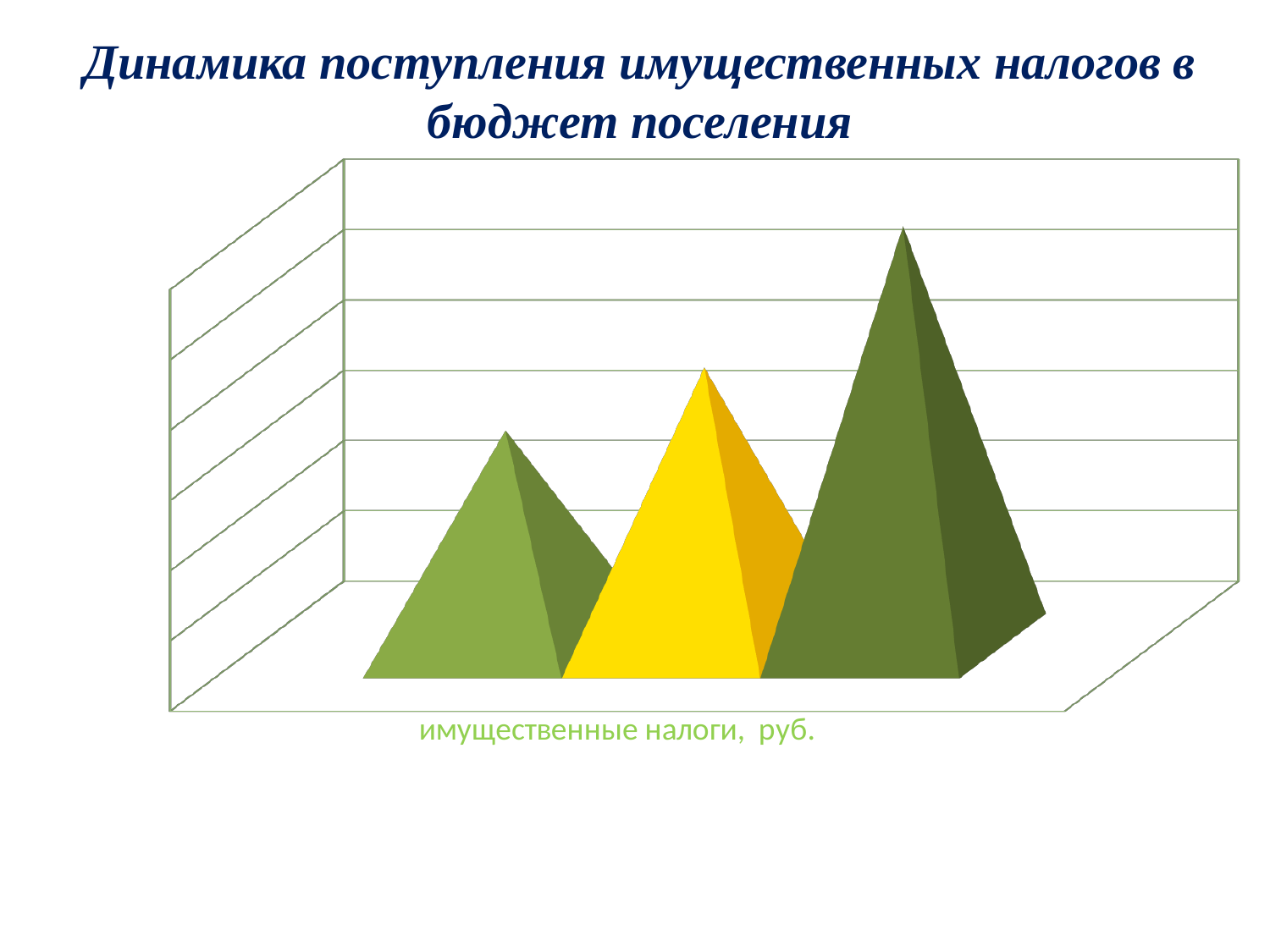
Which bar is the tallest in the chart: the left (light green), the middle (yellow) or the right (dark green)? the right (dark green) What kind of chart is shown on the slide? bar chart How many bars (pyramids) are plotted in the chart? 3 Do the bar heights rise or fall from left to right across the chart? rise Which is taller, the middle yellow bar or the left light green bar? the middle yellow bar Which is taller, the right dark green bar or the middle yellow bar? the right dark green bar Which bar is the shortest in the chart: the left (light green), the middle (yellow) or the right (dark green)? the left (light green) What label is printed below the bars on the category axis? имущественные налоги, руб. What is the title of the slide above the chart? Динамика поступления имущественных налогов в бюджет поселения